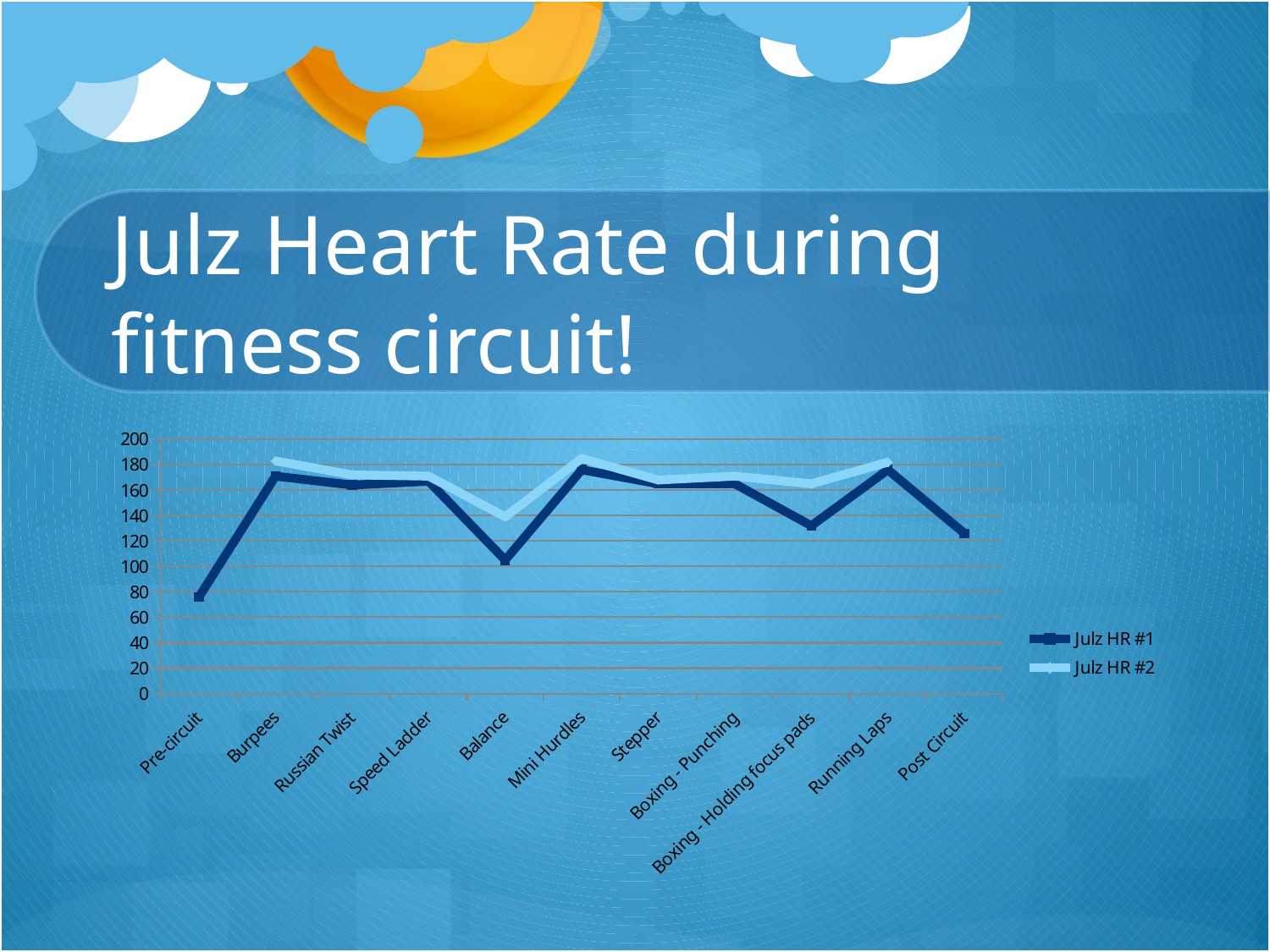
Is the value for Julz HR #1 at Mini Hurdles greater or less than 160? greater What kind of chart is shown on the slide? line chart At Balance, which series has the larger value: Julz HR #1 or Julz HR #2? Julz HR #2 How many series does the legend list? 2 Does the Julz HR #1 line rise or fall from Running Laps to Post Circuit? fall Is the value for Julz HR #1 at Pre-circuit greater or less than 100? less What are the two series named in the legend? Julz HR #1 and Julz HR #2 Which category has the lowest value for Julz HR #2? Balance How many categories are shown along the x axis? 11 Which category has the lowest value for Julz HR #1? Pre-circuit Is the value for Julz HR #1 at Post Circuit greater or less than 140? less Which is larger for Julz HR #1: the value at Balance or the value at Mini Hurdles? Mini Hurdles